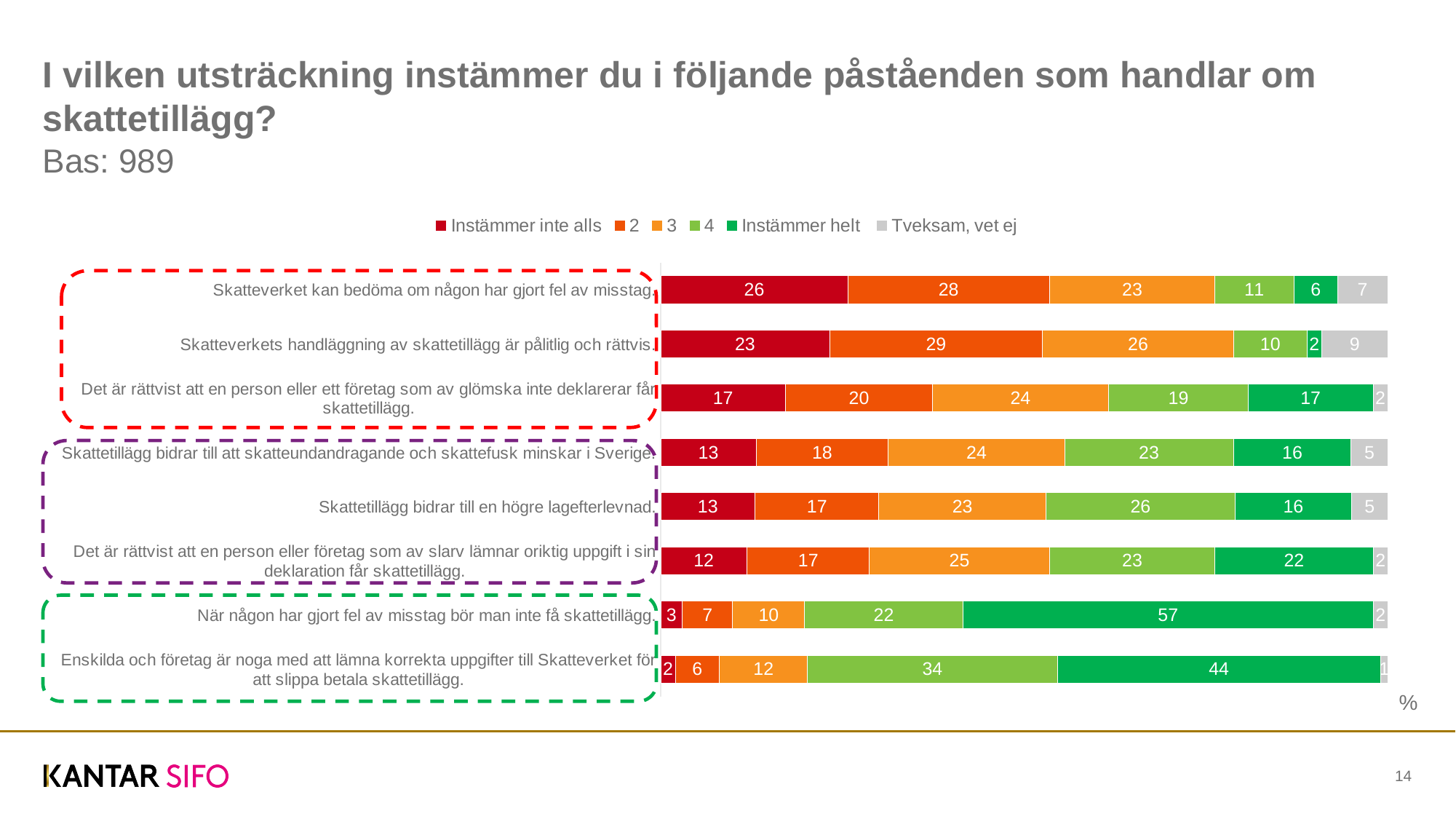
Which statement has the highest 'Instämmer helt' value? När någon har gjort fel av misstag bör man inte få skattetillägg What is the difference between the 'Instämmer helt' values for 'När någon har gjort fel av misstag bör man inte få skattetillägg' and 'Enskilda och företag är noga med att lämna korrekta uppgifter till Skatteverket för att slippa betala skattetillägg'? 13 What is the 'Instämmer inte alls' value for 'Skatteverket kan bedöma om någon har gjort fel av misstag'? 26 What kind of chart is shown on the slide? Stacked bar chart Which statement has the highest 'Instämmer inte alls' value? Skatteverket kan bedöma om någon har gjort fel av misstag What is the 'Instämmer helt' value for 'När någon har gjort fel av misstag bör man inte få skattetillägg'? 57 What is the 'Tveksam, vet ej' value for 'Skatteverkets handläggning av skattetillägg är pålitlig och rättvis'? 9 How many statements (categories) are plotted in the chart? 8 Which is larger: the '2' value for 'Skatteverkets handläggning av skattetillägg är pålitlig och rättvis' or the '2' value for 'Skatteverket kan bedöma om någon har gjort fel av misstag'? Skatteverkets handläggning av skattetillägg är pålitlig och rättvis What is the base (Bas) stated on the slide? 989 What is the value for '4' for 'Enskilda och företag är noga med att lämna korrekta uppgifter till Skatteverket för att slippa betala skattetillägg'? 34 How many series does the legend list? 6